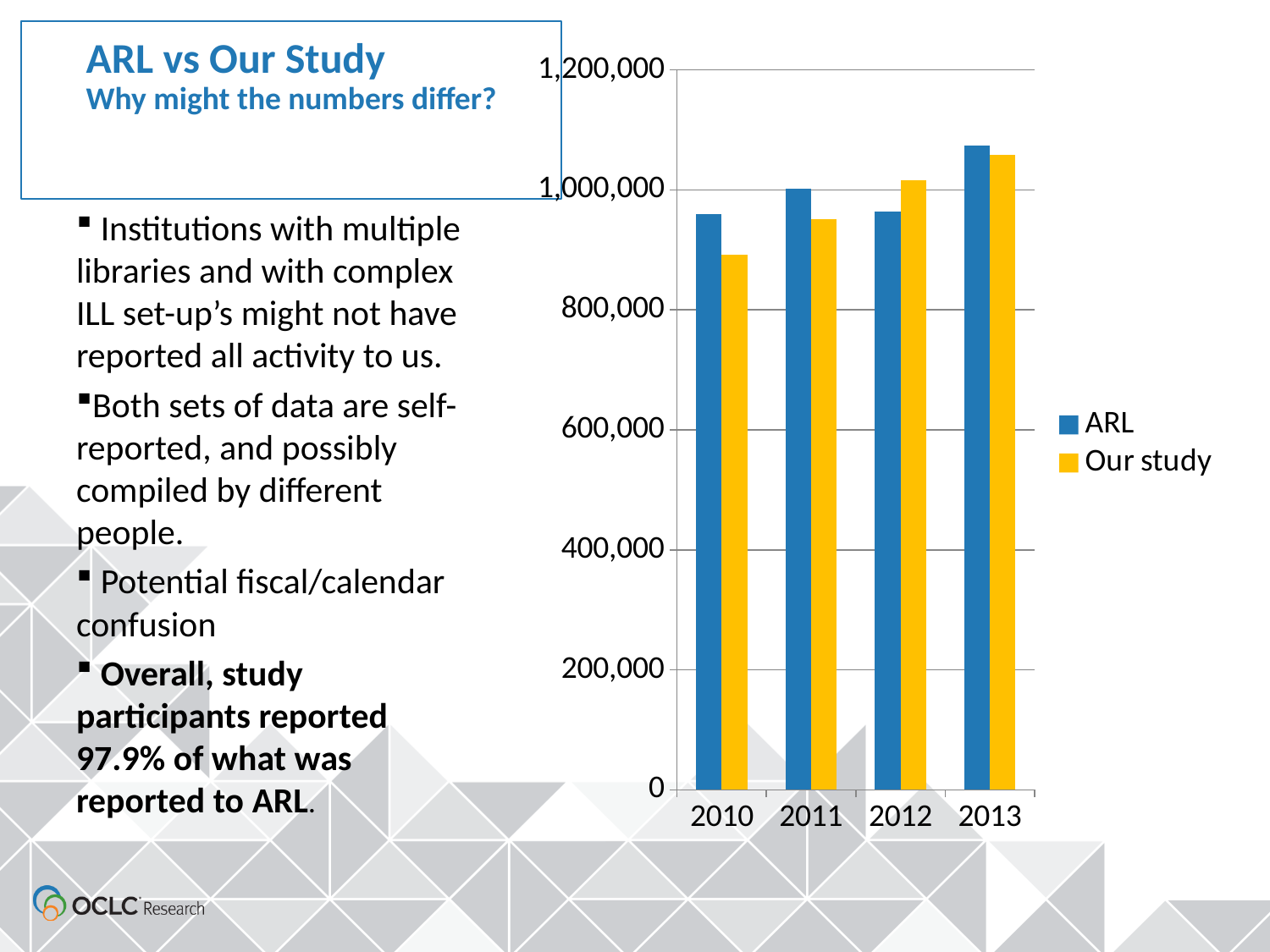
Is the ARL value for 2010 greater or less than 800,000? greater What kind of chart is shown on the slide? bar chart In 2012, which is larger, the ARL value or the Our study value? Our study How many years are shown on the x axis of the chart? 4 Is the Our study value for 2010 greater or less than 1,000,000? less In 2010, which is larger, the ARL value or the Our study value? ARL Is the ARL value for 2013 greater or less than 1,000,000? greater Which two series are listed in the chart legend? ARL and Our study Which year has the lowest Our study value? 2010 How many series does the chart legend list? 2 Do the Our study values rise or fall from 2010 to 2013? rise Which year has the highest ARL value? 2013